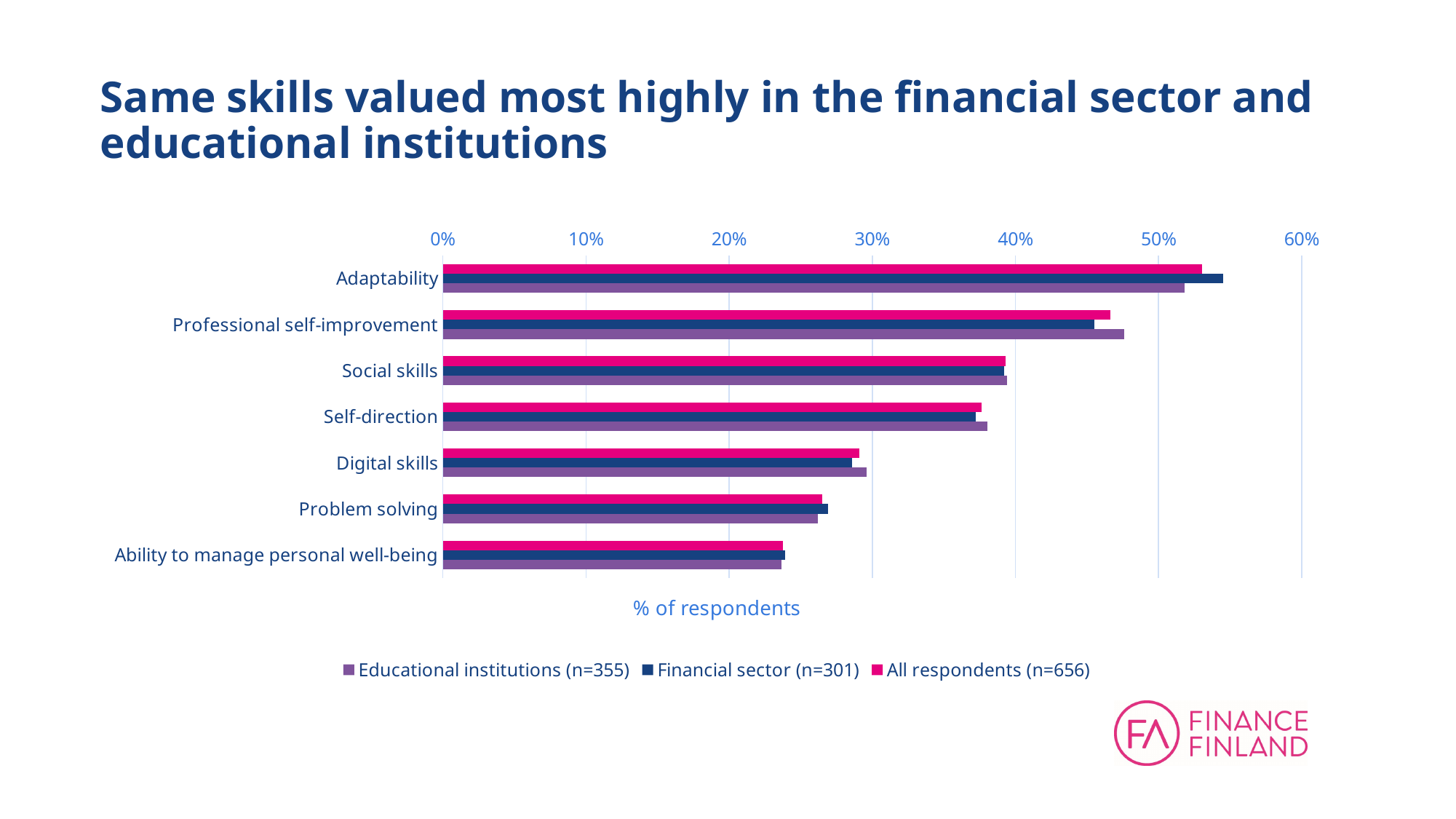
How many series does the legend list? 3 How many skill categories are plotted on the chart? 7 Is the Educational institutions value for Social skills greater or less than 40%? less For Educational institutions, which is larger: Adaptability or Problem solving? Adaptability Which skill has the highest value for the Financial sector series? Adaptability Which skill has the lowest value for the All respondents series? Ability to manage personal well-being What is the label on the horizontal axis of the chart? % of respondents What kind of chart is shown on the slide? Bar chart For Adaptability, which series has the larger value: Financial sector or Educational institutions? Financial sector Is the Financial sector value for Problem solving greater or less than 20%? greater Is the Financial sector value for Adaptability greater or less than 50%? greater